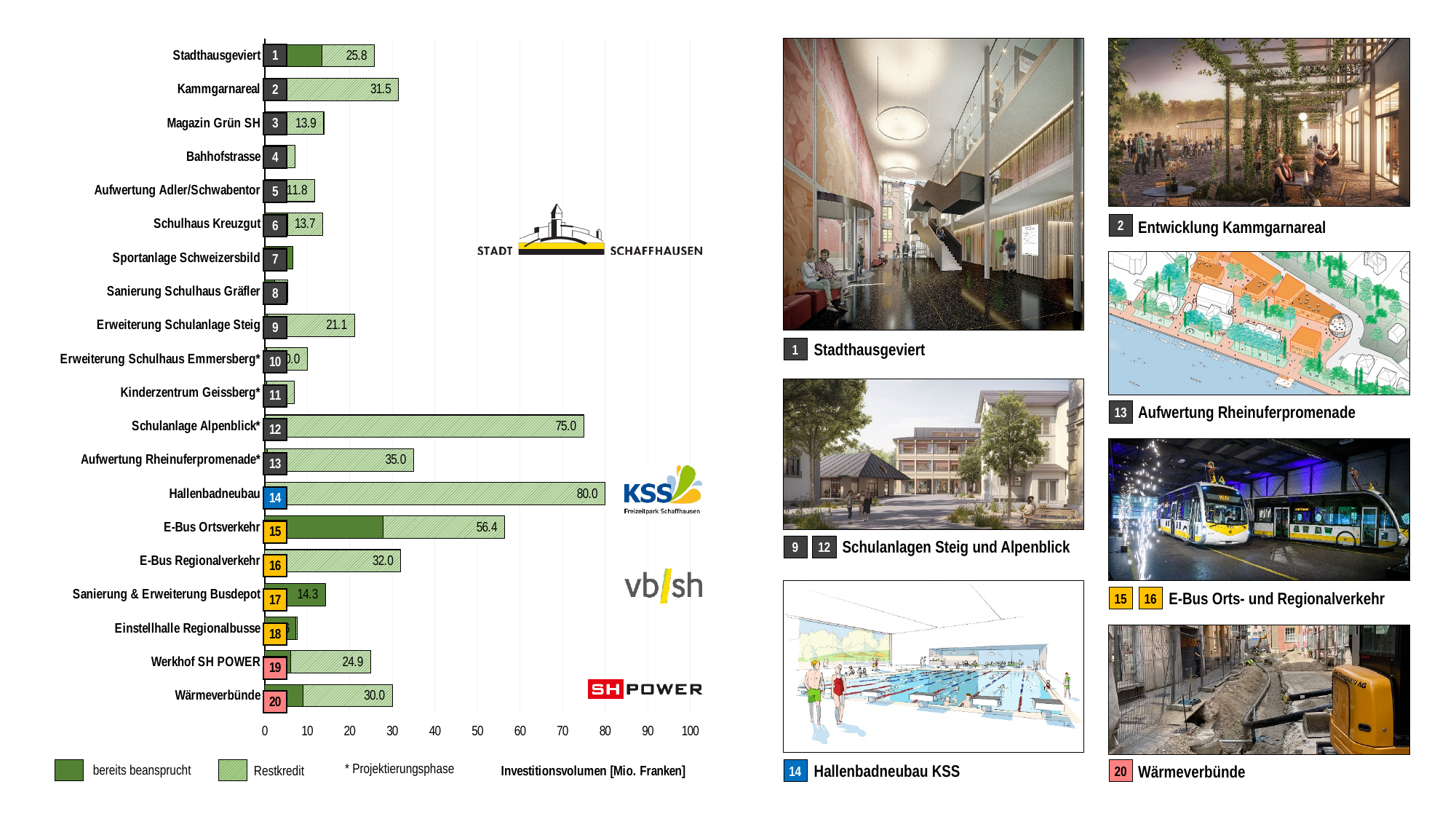
What is the total investment volume shown for Hallenbadneubau? 80.0 How many series does the legend of the chart list? 2 What value is shown for E-Bus Ortsverkehr? 56.4 Which has a larger value, Kammgarnareal or E-Bus Regionalverkehr? E-Bus Regionalverkehr What is the difference between the values for Hallenbadneubau and Schulanlage Alpenblick*? 5.0 What type of chart is used to show the investment volumes? Stacked horizontal bar chart How many projects (categories) are listed in the bar chart? 20 Which project has the highest investment volume in the chart? Hallenbadneubau Is the value for Bahnhofstrasse greater or less than 10? less What is the value labelled for Schulanlage Alpenblick*? 75.0 What unit is given on the x axis of the chart? Investitionsvolumen [Mio. Franken] What value is shown for Werkhof SH POWER? 24.9